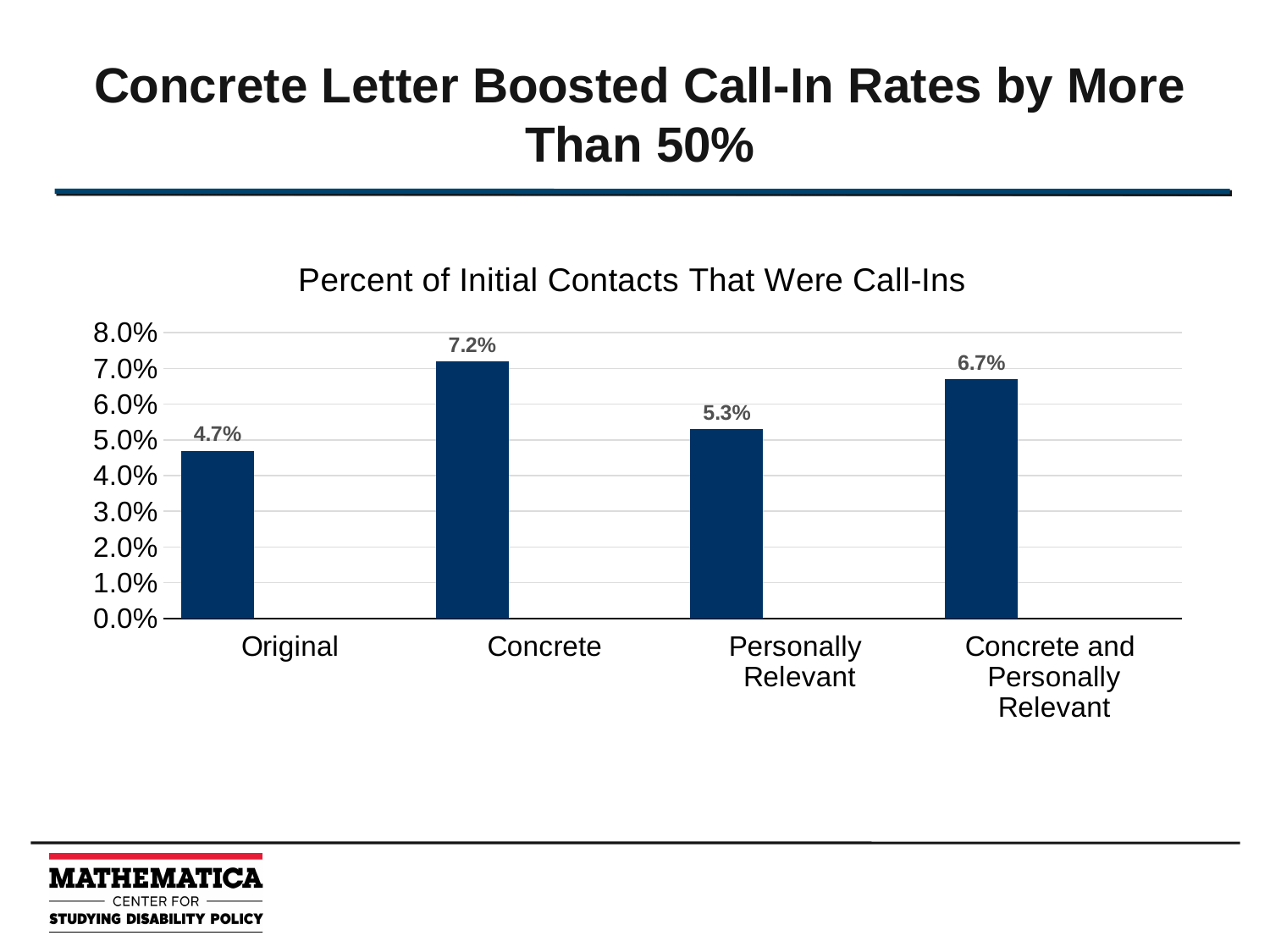
What is the value for Original? 4.7% What is the value for Concrete and Personally Relevant? 6.7% What is the difference between the values for Concrete and Personally Relevant and Personally Relevant? 1.4% What is the title of the chart? Percent of Initial Contacts That Were Call-Ins What is the value for Personally Relevant? 5.3% What kind of chart is shown on the slide? bar chart What is the difference between the values for Concrete and Original? 2.5% What is the value for Concrete? 7.2% Which is larger, the value for Personally Relevant or the value for Concrete and Personally Relevant? Concrete and Personally Relevant Which category has the highest value? Concrete How many categories are shown on the x axis? 4 Which category has the lowest value? Original